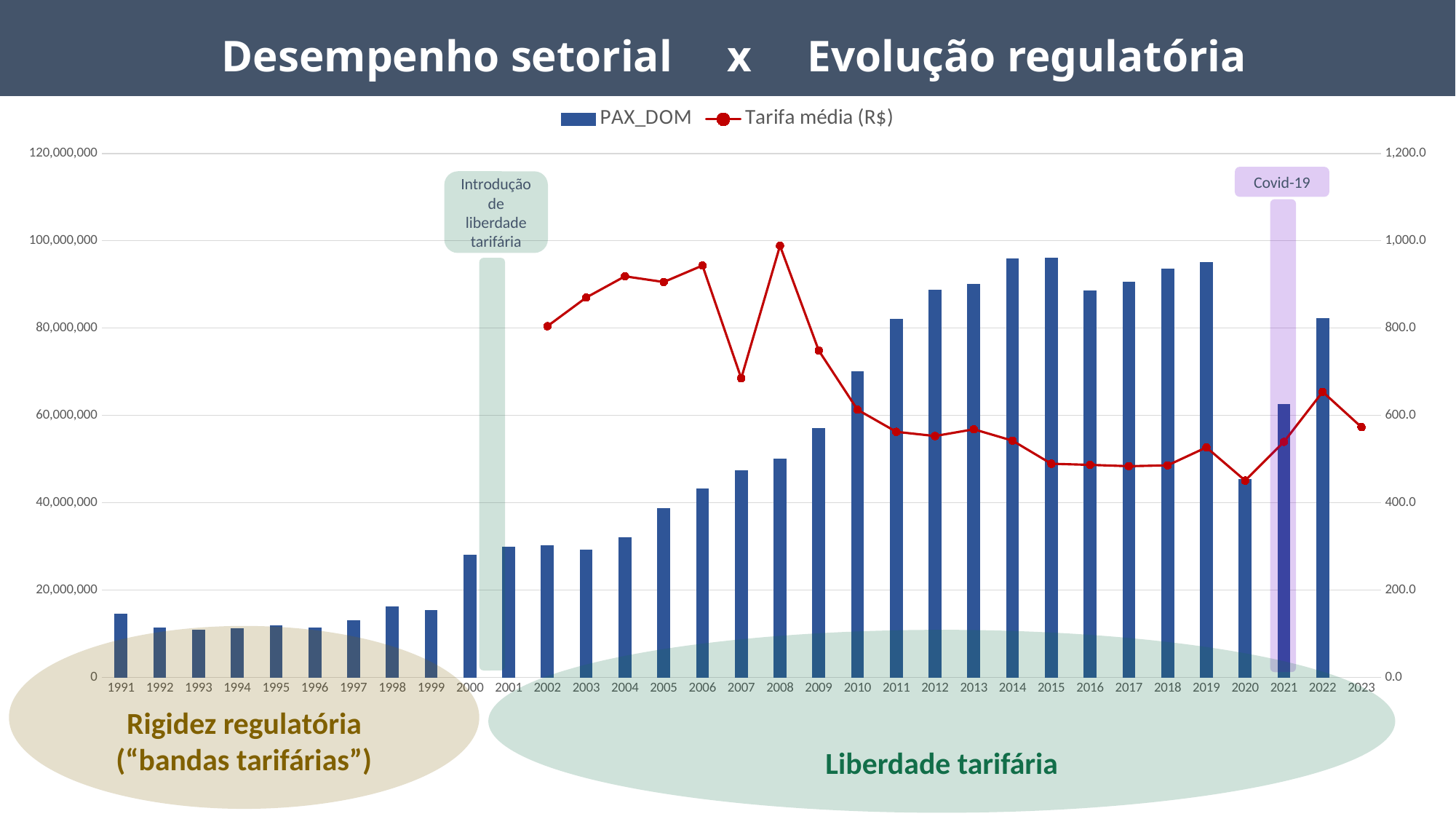
Which year has the larger PAX_DOM bar, 2019 or 2020? 2019 Is the Tarifa média (R$) value for 2008 greater or less than 800.0? greater What kind of chart is shown on the slide? A combined bar and line chart Is the PAX_DOM value for 1991 greater or less than 20,000,000? less In which year does the Tarifa média (R$) line reach its lowest value? 2020 How many series does the legend list? 2 In which year does the Tarifa média (R$) line reach its highest value? 2008 How many years are shown on the x axis? 33 Is the Tarifa média (R$) value for 2017 greater or less than 600.0? less Which year is highlighted with the Covid-19 annotation? 2021 Do the PAX_DOM bars rise or fall from 2009 to 2014? rise